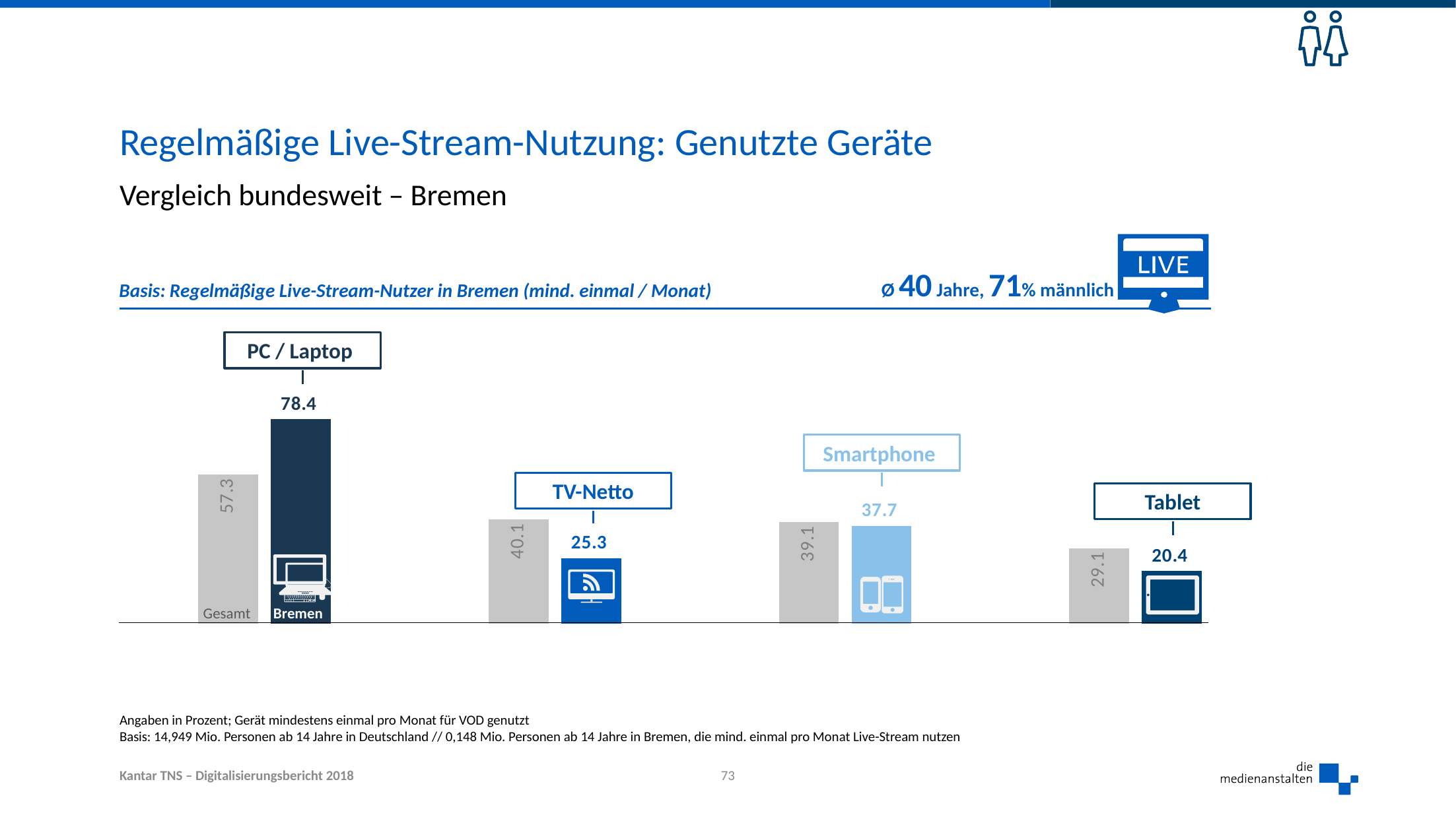
What is the Gesamt value for Tablet? 29.1 What is the Gesamt value for TV-Netto? 40.1 What is the difference between the Bremen and Gesamt values for PC / Laptop? 21.1 What kind of chart is shown on the slide? Bar chart Which device has the lowest Gesamt value? Tablet For Tablet, which is larger: the Gesamt value or the Bremen value? Gesamt What is the difference between the Gesamt and Bremen values for TV-Netto? 14.8 What is the Bremen value for Smartphone? 37.7 Which device has the lowest Bremen value? Tablet Which device has the highest Bremen value? PC / Laptop What is the Bremen value for PC / Laptop? 78.4 How many device categories are shown in the chart? 4